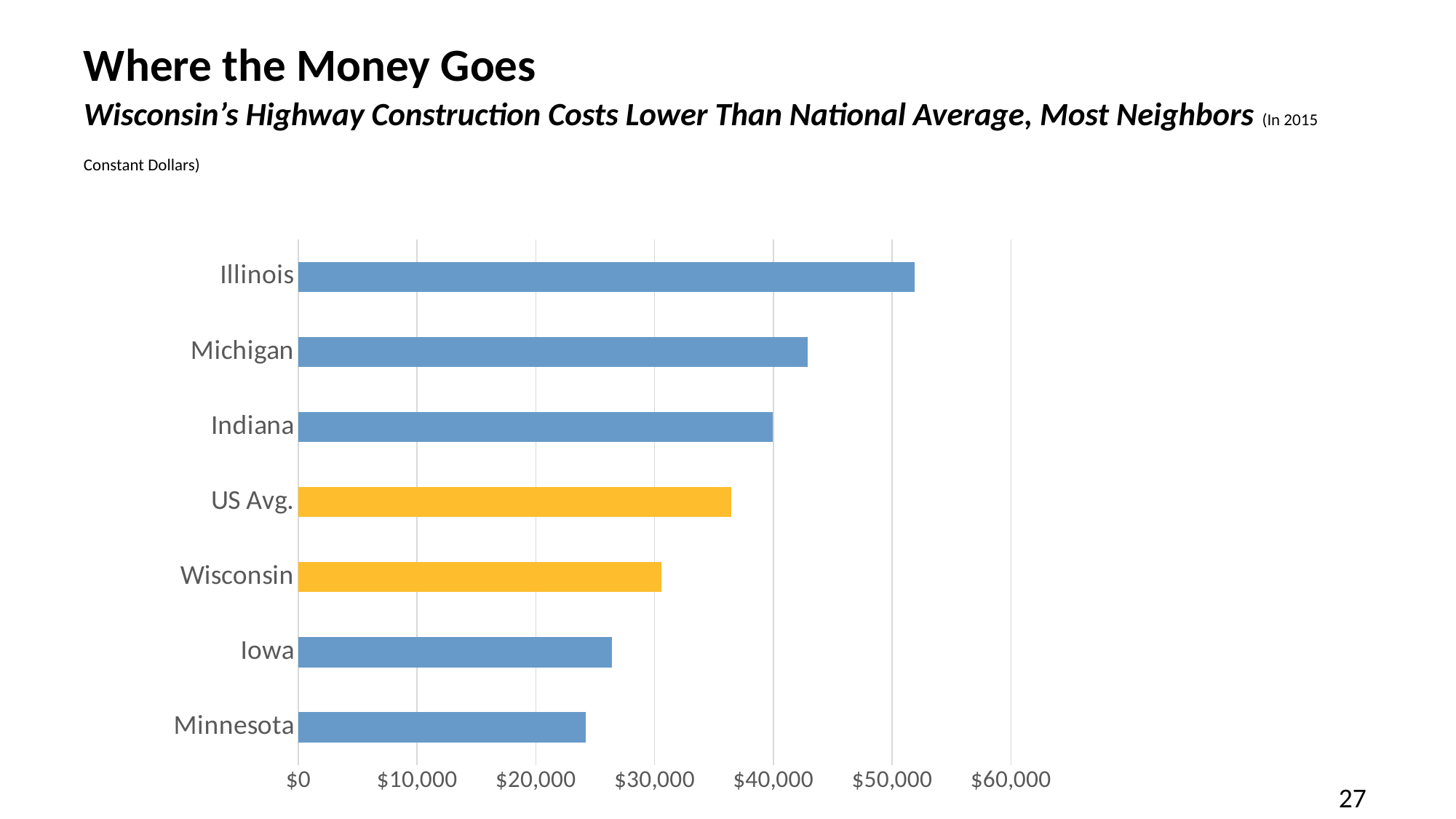
Which is larger, the value for Wisconsin or the value for US Avg.? US Avg. Which category has the highest highway construction cost in the chart? Illinois Which category has the lowest highway construction cost in the chart? Minnesota Is the value for Iowa greater or less than $30,000? less Is the value for Illinois greater or less than $50,000? greater What is the main title of the slide? Where the Money Goes How many categories (bars) are shown in the chart? 7 Is the value for US Avg. greater or less than $40,000? less Which is larger, the value for Iowa or the value for Minnesota? Iowa Which two bars in the chart are coloured yellow/orange rather than blue? US Avg. and Wisconsin What kind of chart is shown on the slide? Bar chart